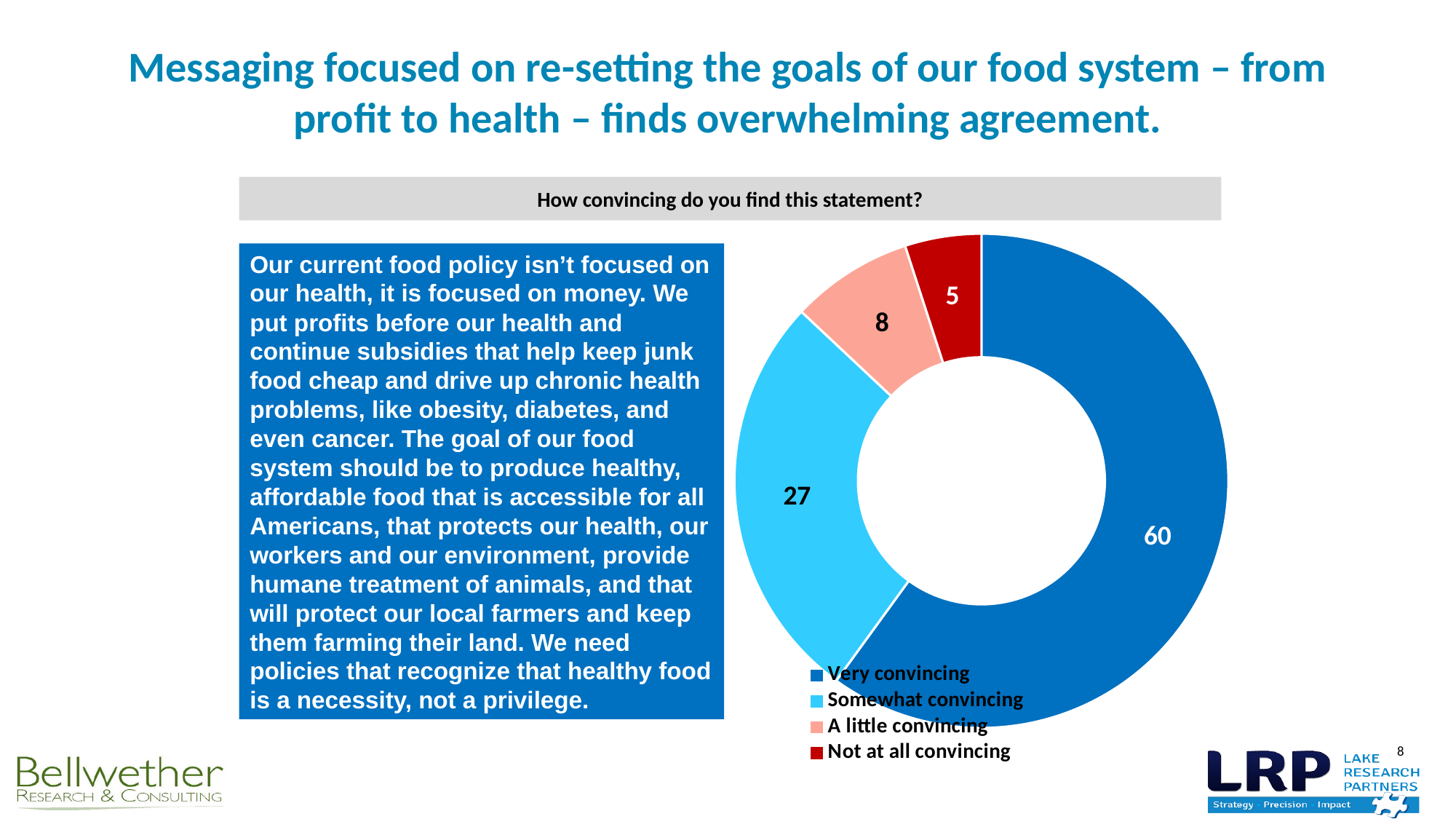
What value is shown for "A little convincing" in the donut chart? 8 Which response category has the largest slice in the chart? Very convincing How many response categories does the chart show? 4 What kind of chart is shown on the slide? Donut (pie) chart What value is shown for "Very convincing" in the donut chart? 60 What is the difference between the values for "Very convincing" and "Somewhat convincing"? 33 What value is shown for "Somewhat convincing" in the donut chart? 27 What is the combined value of "Very convincing" and "Somewhat convincing"? 87 Which is larger: the value for "A little convincing" or the value for "Not at all convincing"? A little convincing What question does the header above the chart ask? How convincing do you find this statement? Which response category has the smallest slice in the chart? Not at all convincing What value is shown for "Not at all convincing" in the donut chart? 5